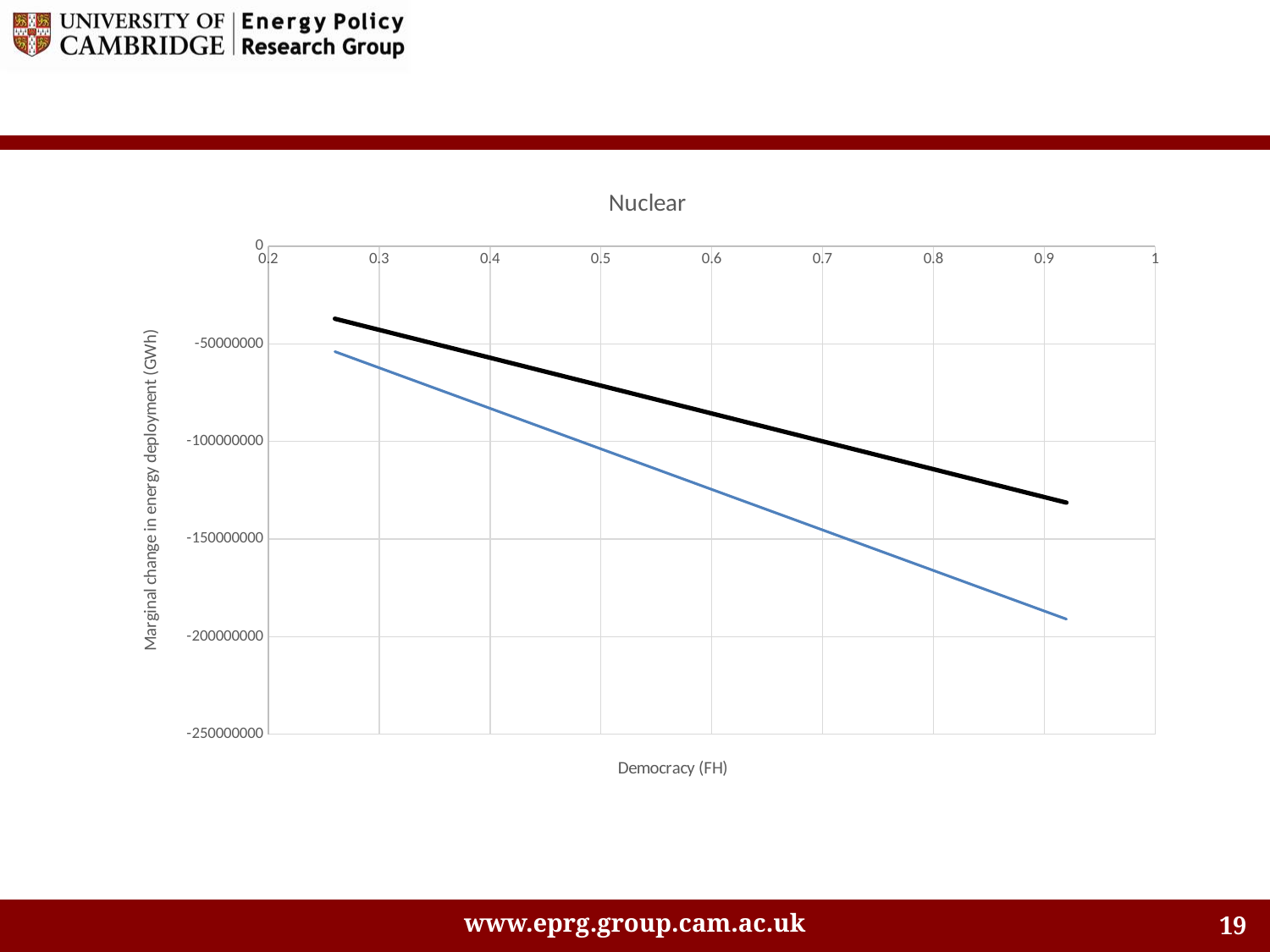
Do the values of the blue line rise or fall as Democracy (FH) increases? fall At Democracy (FH) = 0.6, which line has the higher value, the black line or the blue line? black line What is the label of the y axis? Marginal change in energy deployment (GWh) What is the title of the chart? Nuclear Is the value of the blue line at Democracy (FH) = 0.9 greater or less than -150000000? less Is the value of the blue line at Democracy (FH) = 0.6 greater or less than -100000000? less Do the values of the black line rise or fall as Democracy (FH) increases? fall Is the value of the blue line at Democracy (FH) = 0.3 greater or less than -50000000? less What type of chart is shown on the slide? line chart How many lines are plotted on the chart? 2